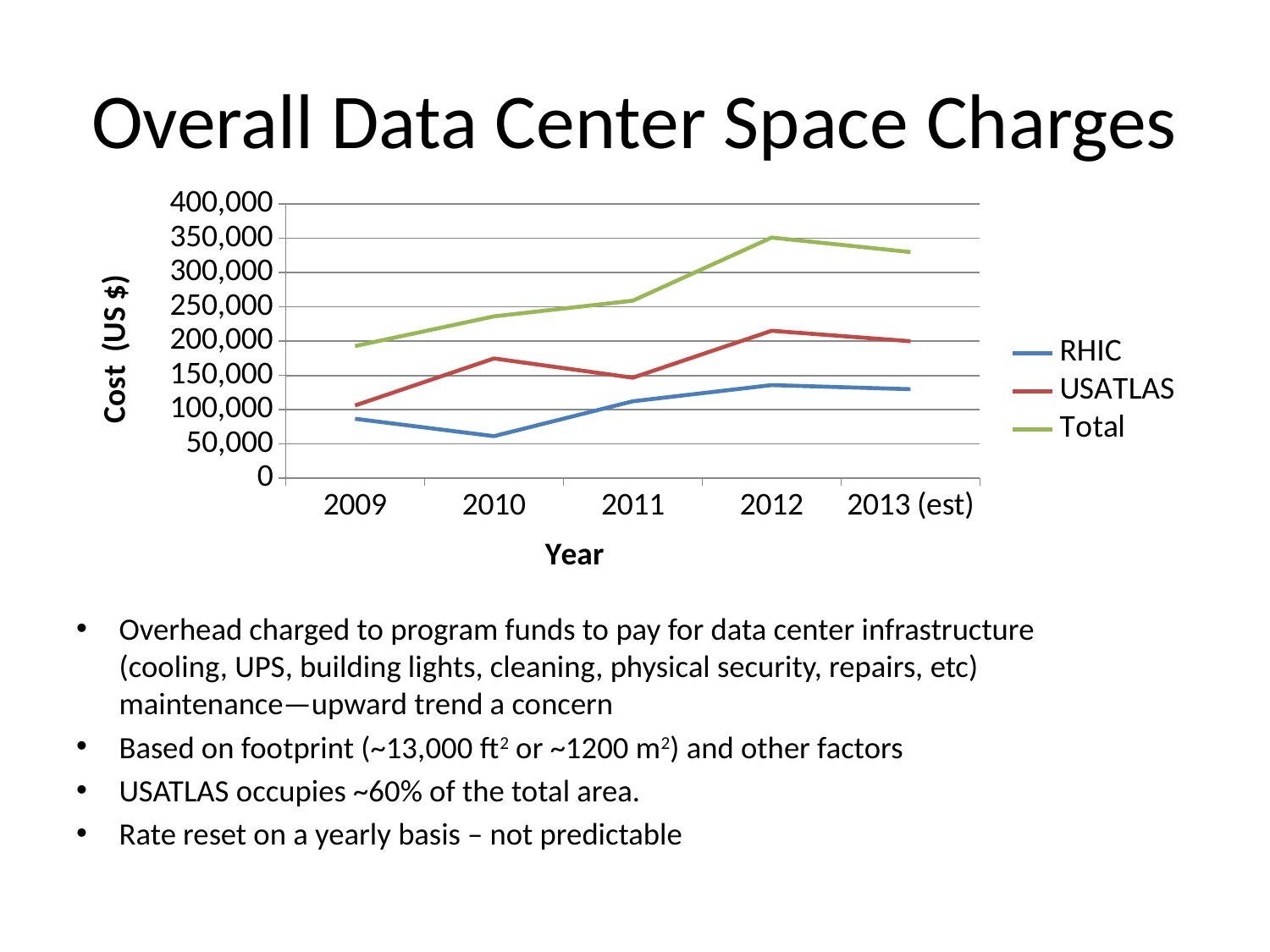
How many series does the legend list? 3 Is the Total value for 2012 greater or less than 300,000? greater Is the RHIC value for 2010 greater or less than 100,000? less Which series has the larger value in 2011, RHIC or USATLAS? USATLAS What is the title of the y axis? Cost (US $) How many years are plotted along the x axis? 5 Is the USATLAS value for 2009 greater or less than 150,000? less In which year is the Total line at its highest? 2012 Does the Total line generally rise or fall from 2009 to 2012? rise In which year is the USATLAS line at its highest? 2012 In which year is the RHIC line at its lowest? 2010 What kind of chart is shown on the slide? line chart